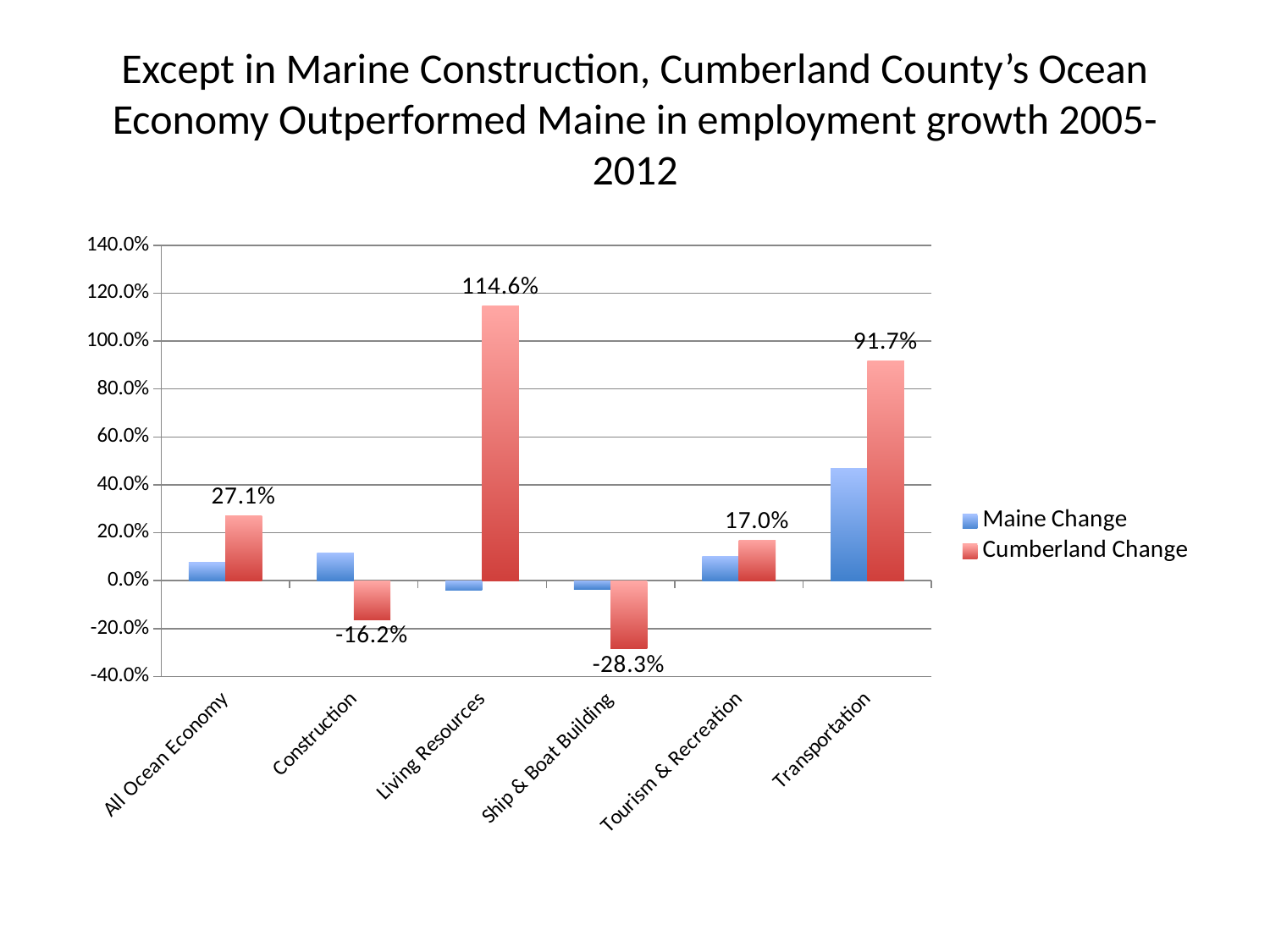
What kind of chart is shown on the slide? Bar chart How many series does the legend list? 2 What is the Cumberland Change value for Living Resources? 114.6% How many categories are shown on the x axis? 6 What is the Cumberland Change value for Transportation? 91.7% What is the difference between the Cumberland Change values for Living Resources and Transportation? 22.9 percentage points What colour are the Cumberland Change bars? Red Is the Maine Change value for Transportation greater or less than 40.0%? greater What is the Cumberland Change value for Ship & Boat Building? -28.3% Which category has the lowest Cumberland Change value? Ship & Boat Building For Construction, which is larger: the Maine Change or the Cumberland Change? Maine Change Which category has the highest Cumberland Change value? Living Resources